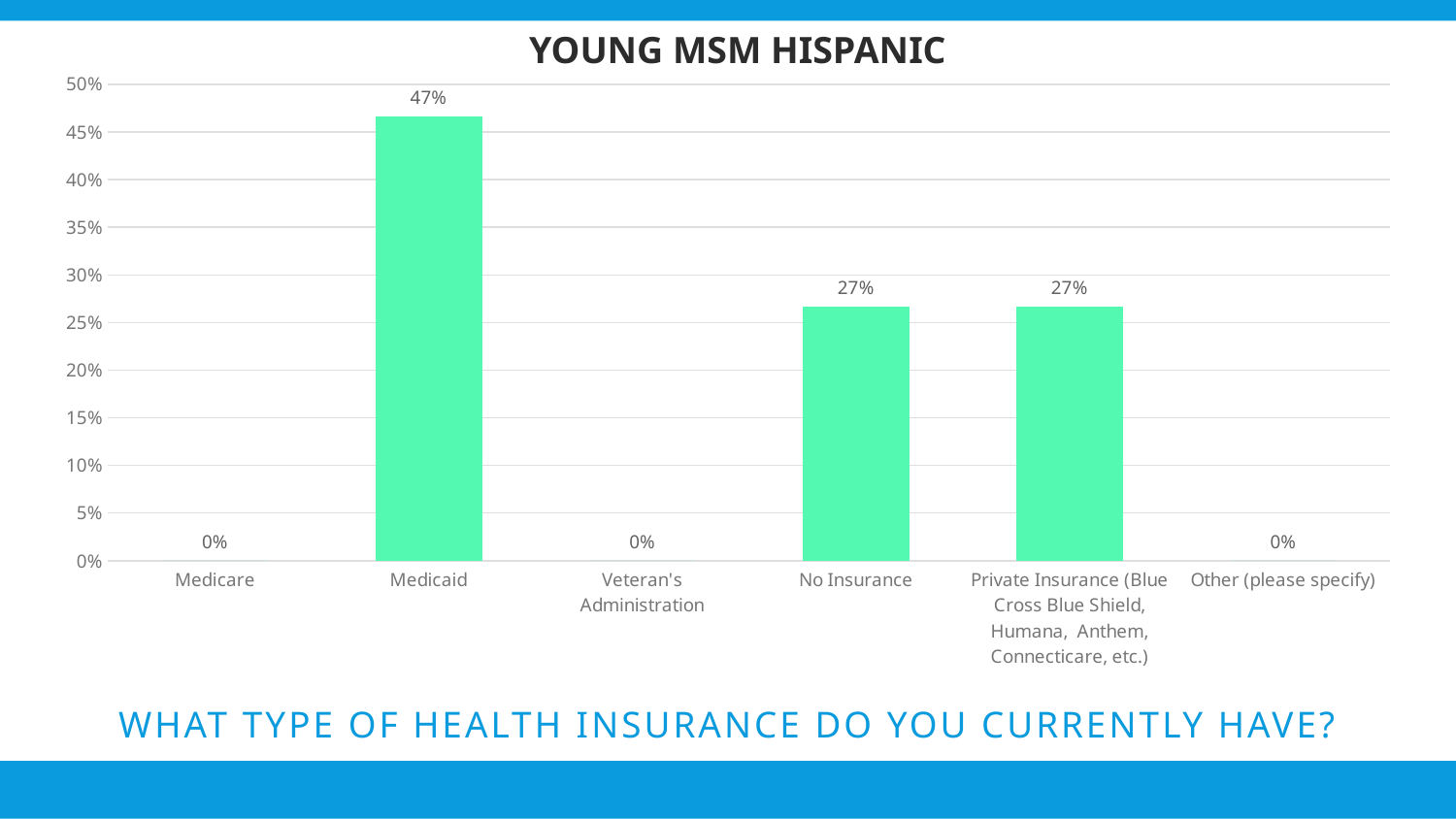
What is the value for Medicare? 0% Which is larger, the value for Medicaid or the value for Private Insurance (Blue Cross Blue Shield, Humana, Anthem, Connecticare, etc.)? Medicaid What is the value for No Insurance? 27% What is the value for Veteran's Administration? 0% Is the value for Medicaid greater or less than 40%? greater What is the title of the chart? YOUNG MSM HISPANIC How many categories have a value of 0%? 3 Which category has the highest value? Medicaid What is the value for Medicaid? 47% What is the difference between the values for Medicaid and No Insurance? 20% What kind of chart is shown on the slide? bar chart How many categories are shown on the x axis? 6